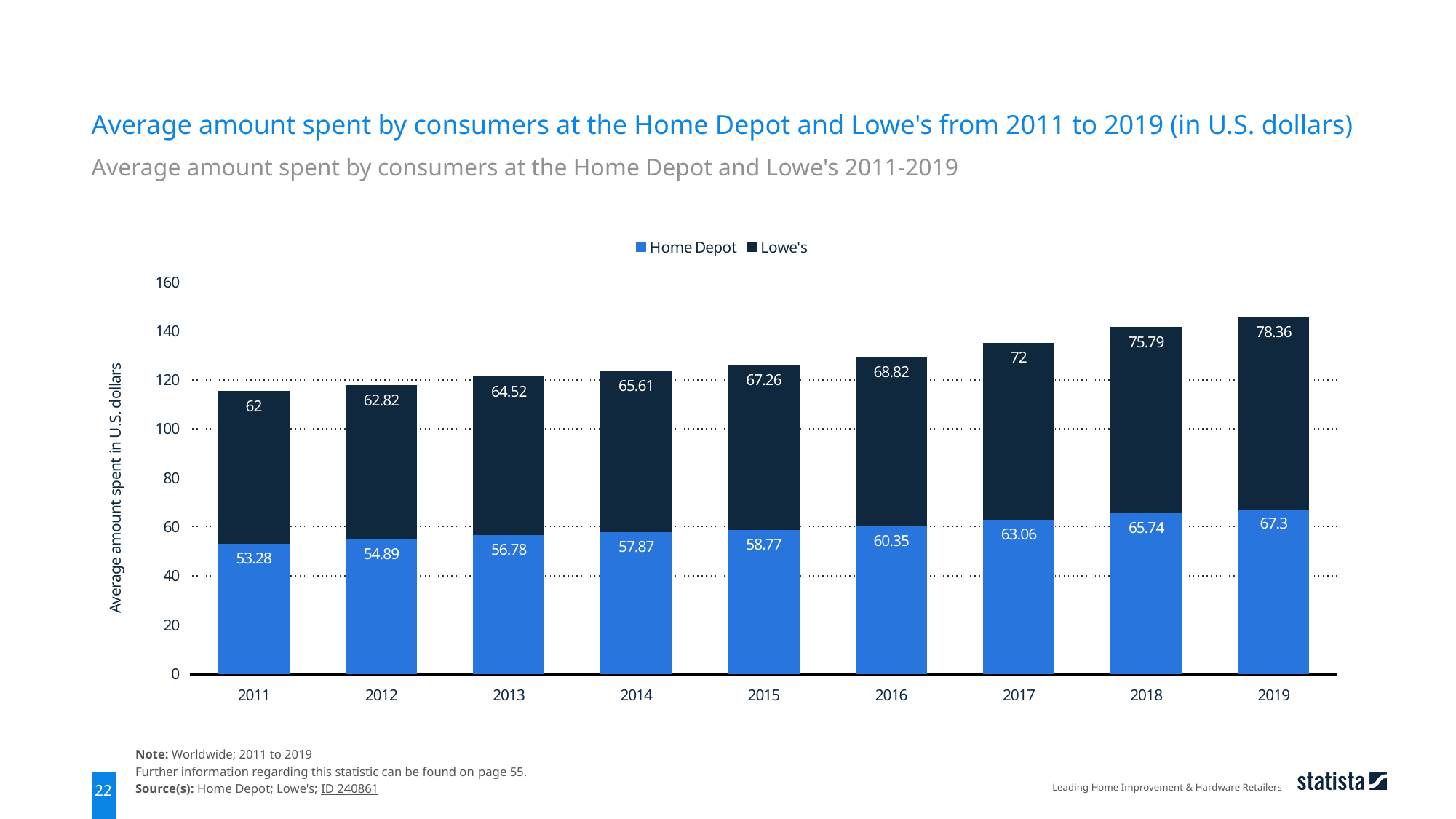
In which year was the Home Depot value the highest? 2019 What is the total of the stacked bar for 2011? 115.28 How many series does the legend list? 2 In which year was the Lowe's value the lowest? 2011 How many years are shown on the x axis? 9 What was the average amount spent by consumers at Lowe's in 2017? 72 Which is larger in 2011, the Home Depot value or the Lowe's value? Lowe's What was the average amount spent by consumers at Home Depot in 2015? 58.77 What is the difference between the Lowe's and Home Depot values in 2019? 11.06 Do the Home Depot values rise or fall from 2011 to 2019? Rise What is the total of the stacked bar for 2019? 145.66 What kind of chart is shown on the slide? Stacked bar chart